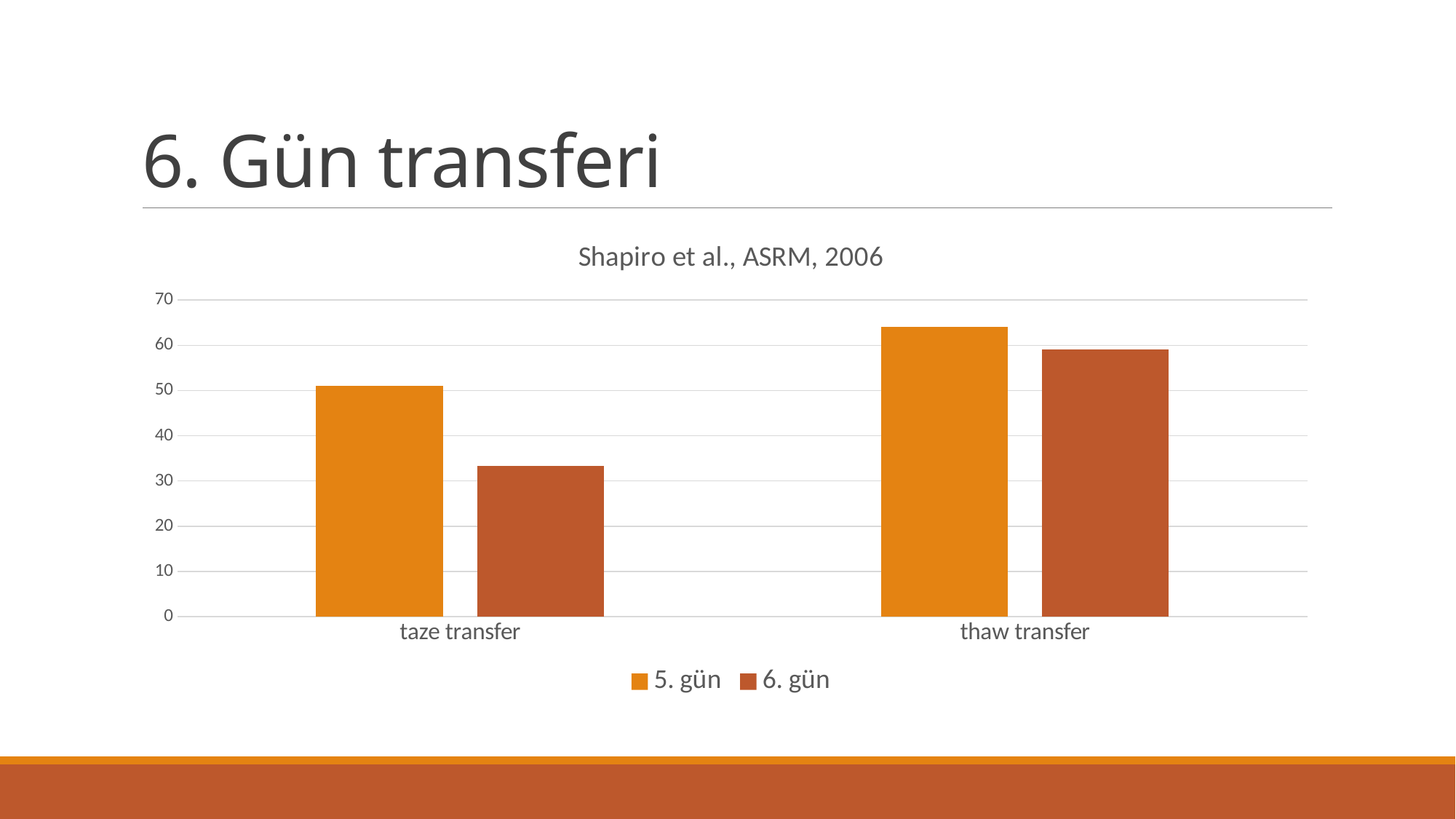
Is the value for 5. gün in thaw transfer greater or less than 60? greater What is the title of the chart? Shapiro et al., ASRM, 2006 What kind of chart is shown on the slide? bar chart Which category has the highest 5. gün value? thaw transfer Is the value for 6. gün in thaw transfer greater or less than 50? greater Which category has the lowest 6. gün value? taze transfer How many categories are shown on the x axis? 2 How many series does the legend list? 2 Is the value for 6. gün in taze transfer greater or less than 40? less Which is larger for taze transfer, 5. gün or 6. gün? 5. gün Which series is shown in the lighter orange colour? 5. gün